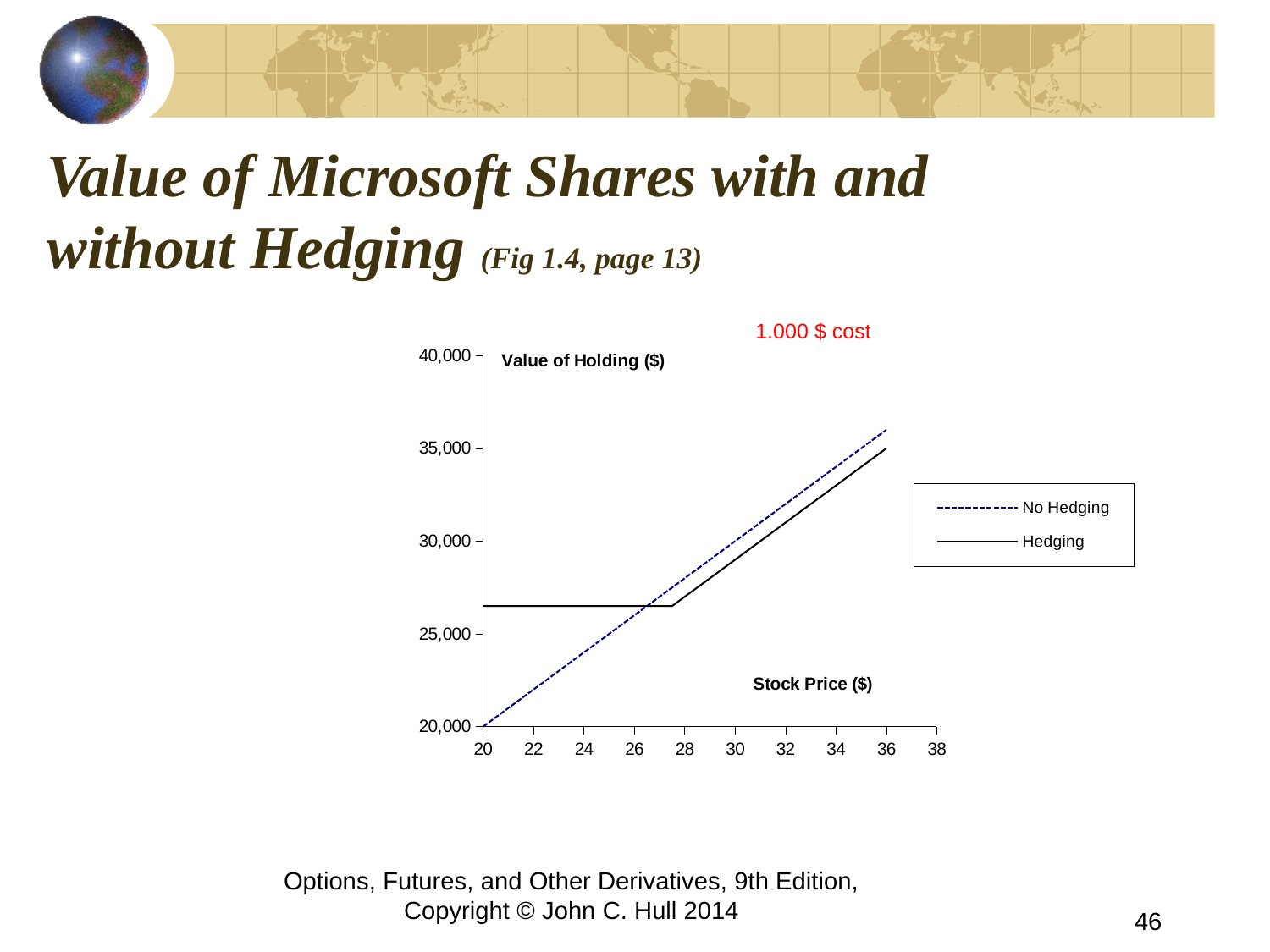
Is the value of the Hedging series at a stock price of 22 greater or less than 25,000? greater What are the two series named in the chart's legend? No Hedging and Hedging Is the value of the No Hedging series at a stock price of 22 greater or less than 25,000? less Does the No Hedging series rise or fall as the stock price increases from 20 to 36? rise How many series does the chart's legend list? 2 Is the value of the No Hedging series at a stock price of 34 greater or less than 30,000? greater What is the value of the Hedging series at a stock price of 36? 35,000 What is the label of the chart's vertical axis? Value of Holding ($) At a stock price of 22, which series has the higher value, Hedging or No Hedging? Hedging What kind of chart is shown on the slide? line chart What is the value of the No Hedging series at a stock price of 20? 20,000 At a stock price of 36, which series has the higher value, Hedging or No Hedging? No Hedging